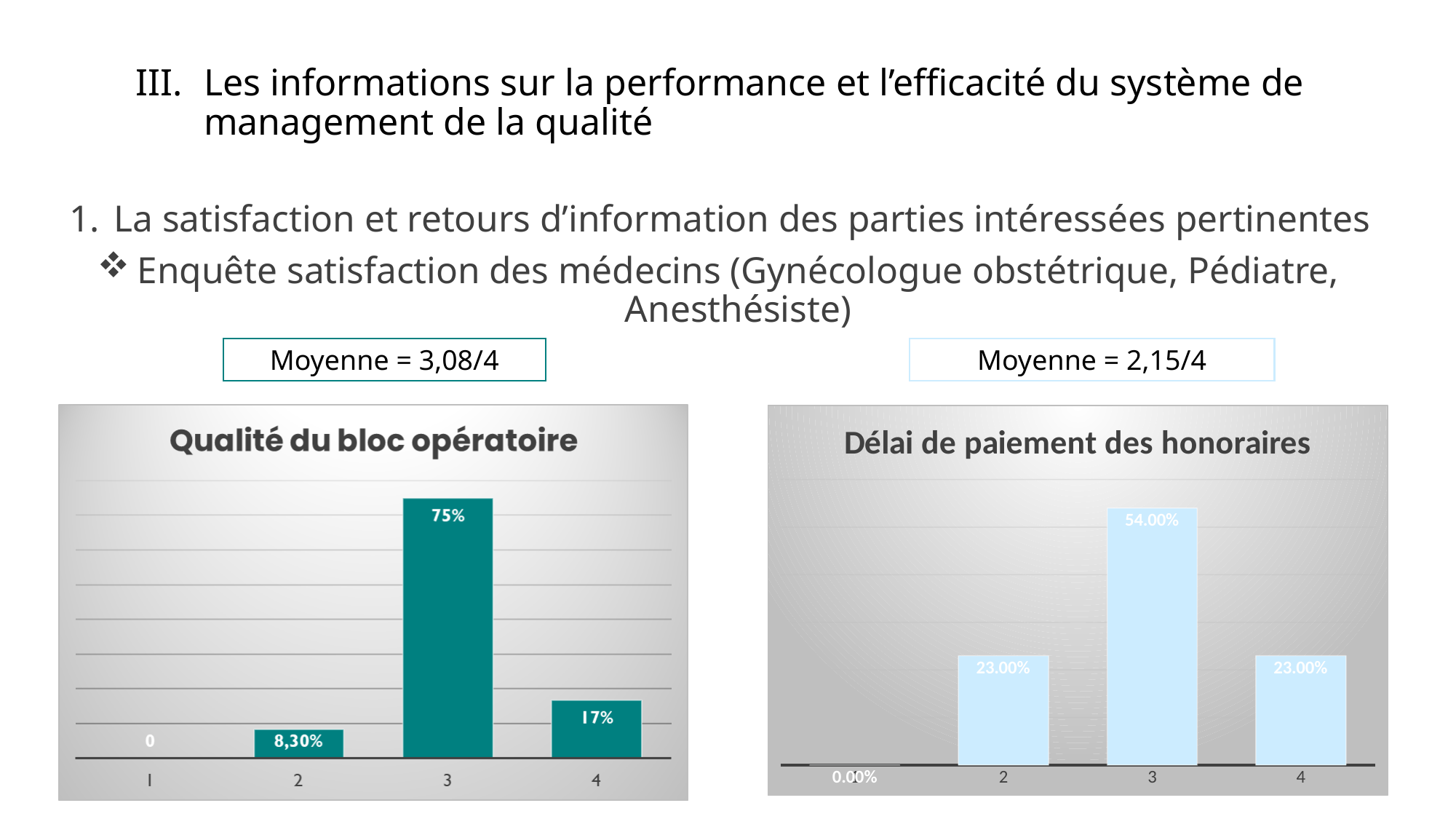
In the 'Qualité du bloc opératoire' chart, what is the value for category 3? 75% In the 'Délai de paiement des honoraires' chart, what is the difference between the values for category 3 and category 4? 31.00% In the 'Délai de paiement des honoraires' chart, what is the value for category 2? 23.00% In the 'Délai de paiement des honoraires' chart, which category has the highest value? 3 What type of chart is the 'Qualité du bloc opératoire' chart? bar chart In the 'Qualité du bloc opératoire' chart, how many categories are shown on the x axis? 4 In the 'Délai de paiement des honoraires' chart, is the value for category 2 larger or smaller than the value for category 3? smaller In the 'Délai de paiement des honoraires' chart, what is the value for category 3? 54.00% In the 'Qualité du bloc opératoire' chart, what is the value for category 2? 8,30% In the 'Qualité du bloc opératoire' chart, which category has the lowest value? 1 In the 'Qualité du bloc opératoire' chart, what is the value for category 4? 17% In the 'Qualité du bloc opératoire' chart, which category has the highest value? 3